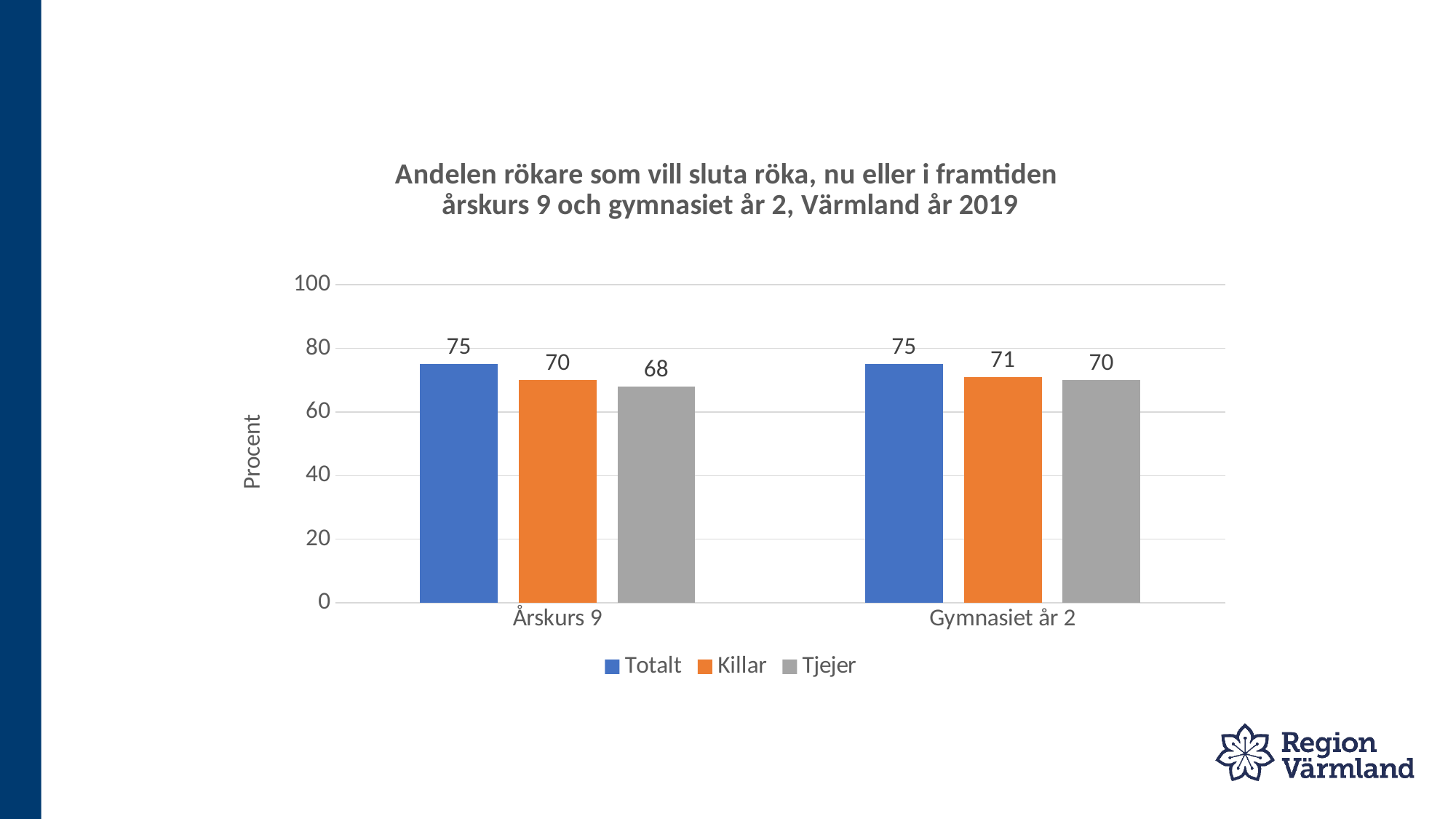
Is the Killar value in Gymnasiet år 2 greater or less than 80? less What is the value for Killar in Gymnasiet år 2? 71 What is the value for Killar in Årskurs 9? 70 What is the value for Totalt in Årskurs 9? 75 What is the value for Tjejer in Gymnasiet år 2? 70 How many categories are shown on the x axis? 2 What is the difference between the Tjejer values for Gymnasiet år 2 and Årskurs 9? 2 What is the difference between the Totalt and Tjejer values in Årskurs 9? 7 Which series has the lowest value in Årskurs 9? Tjejer What kind of chart is shown on the slide? bar chart What is the value for Tjejer in Årskurs 9? 68 How many series does the legend list? 3